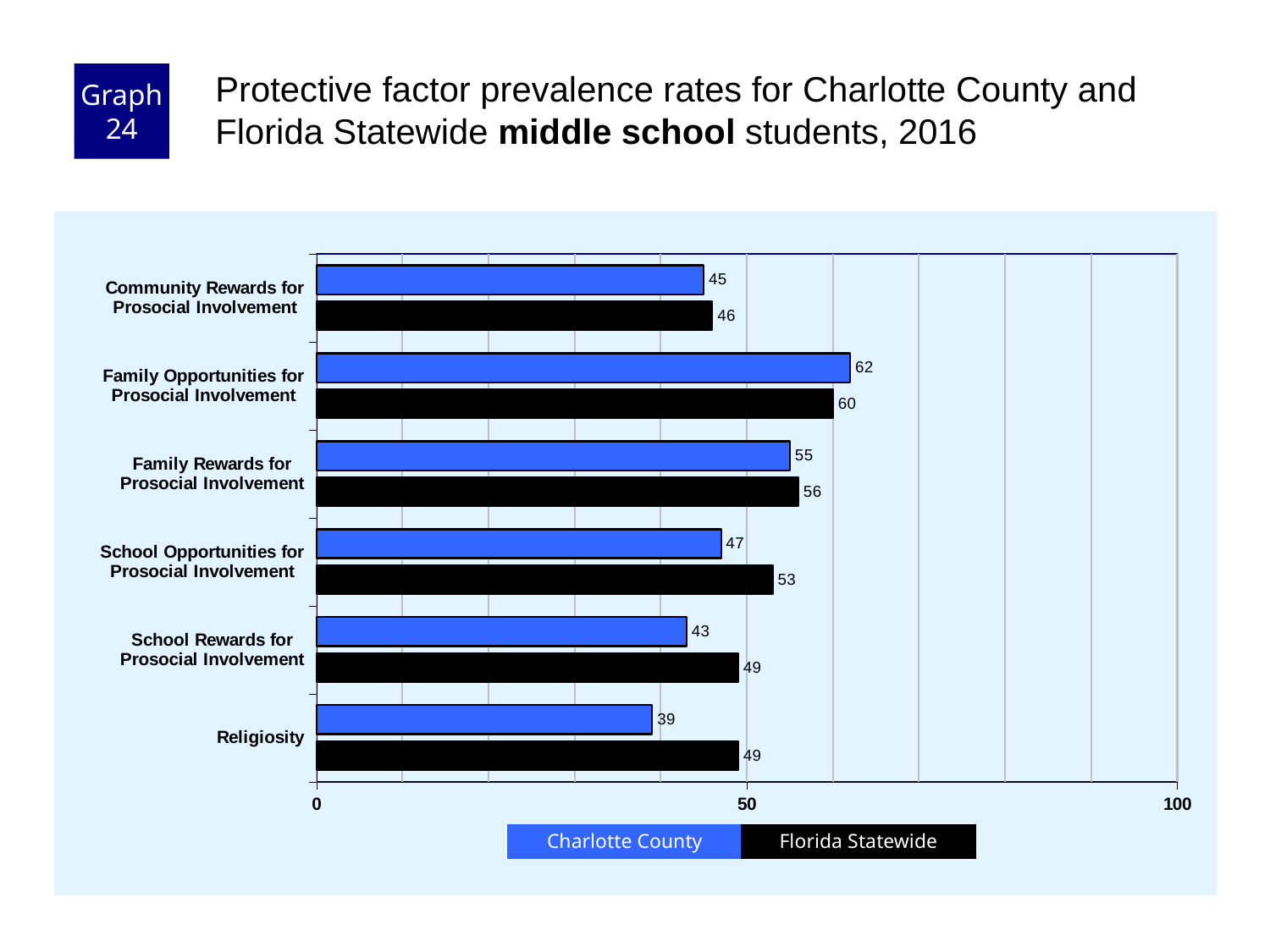
What is the difference between the Florida Statewide and Charlotte County values for Religiosity? 10 Which category has the highest Charlotte County value? Family Opportunities for Prosocial Involvement What kind of chart is shown on the slide? Bar chart Which category has the lowest Florida Statewide value? Community Rewards for Prosocial Involvement What is the difference between the Florida Statewide and Charlotte County values for School Rewards for Prosocial Involvement? 6 Which category has the lowest Charlotte County value? Religiosity How many series does the legend list? 2 How many categories are shown on the chart? 6 What is the Charlotte County value for Religiosity? 39 What is the Charlotte County value for Family Opportunities for Prosocial Involvement? 62 What is the Florida Statewide value for School Opportunities for Prosocial Involvement? 53 For Family Opportunities for Prosocial Involvement, which is larger: Charlotte County or Florida Statewide? Charlotte County